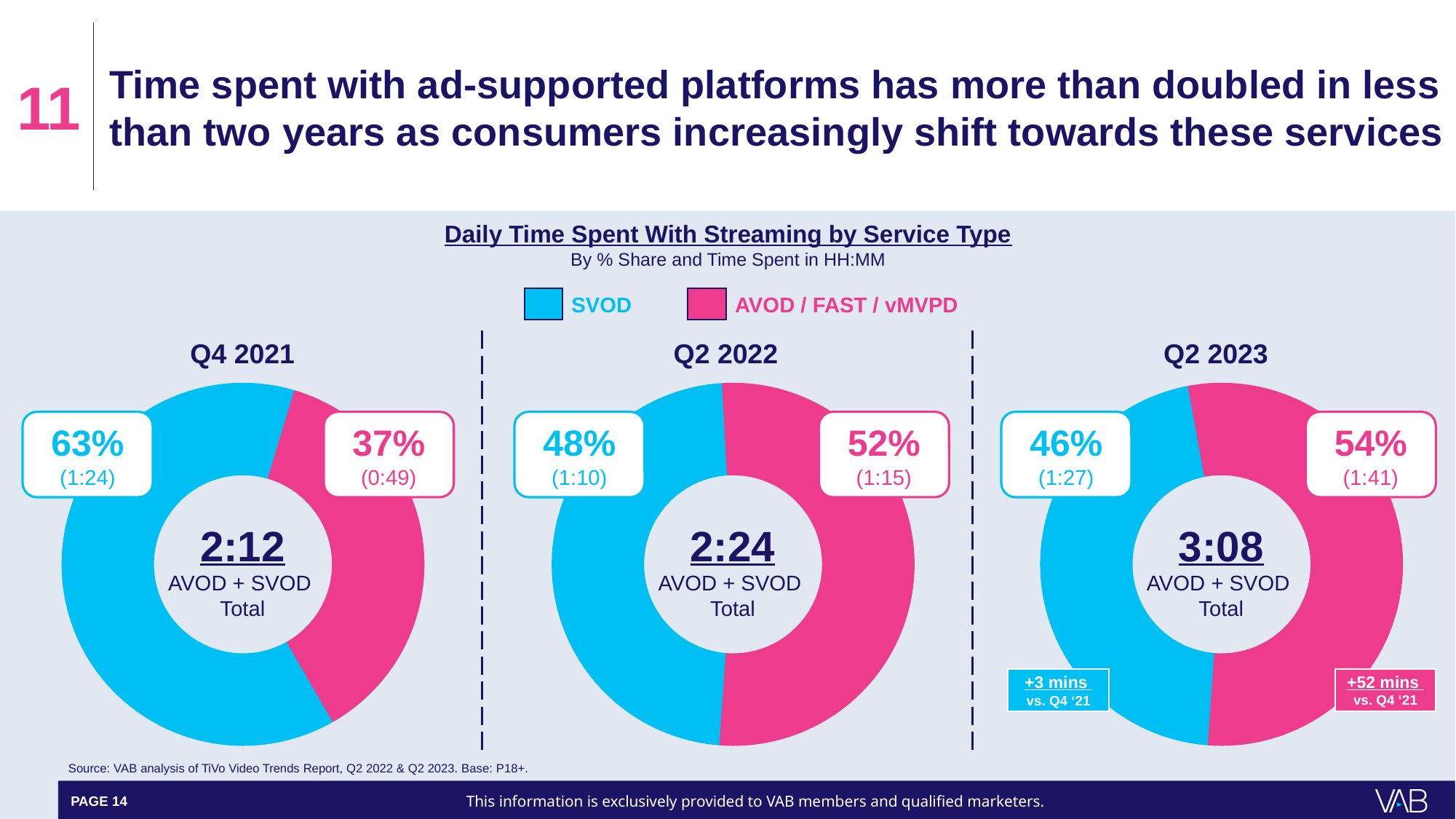
How many series does the legend list? 2 In the Q4 2021 chart, what share of daily streaming time is SVOD? 63% Across the three charts from Q4 2021 to Q2 2023, does the AVOD / FAST / vMVPD share rise or fall? Rise In the Q2 2022 chart, how much daily time is spent with SVOD? 1:10 What kind of chart is used to show the Q2 2022 data? Donut (pie) chart In the Q4 2021 chart, how much daily time is spent with AVOD / FAST / vMVPD? 0:49 In the Q2 2023 chart, how much daily time is spent with AVOD / FAST / vMVPD? 1:41 In the Q4 2021 chart, which service type has the larger share, SVOD or AVOD / FAST / vMVPD? SVOD In the Q2 2023 chart, what is the difference in percentage points between the AVOD / FAST / vMVPD share and the SVOD share? 8 In the Q2 2023 chart, what is the AVOD + SVOD total daily time spent? 3:08 In the Q2 2023 chart, what share of daily streaming time is SVOD? 46% In the Q2 2022 chart, what share of daily streaming time is AVOD / FAST / vMVPD? 52%